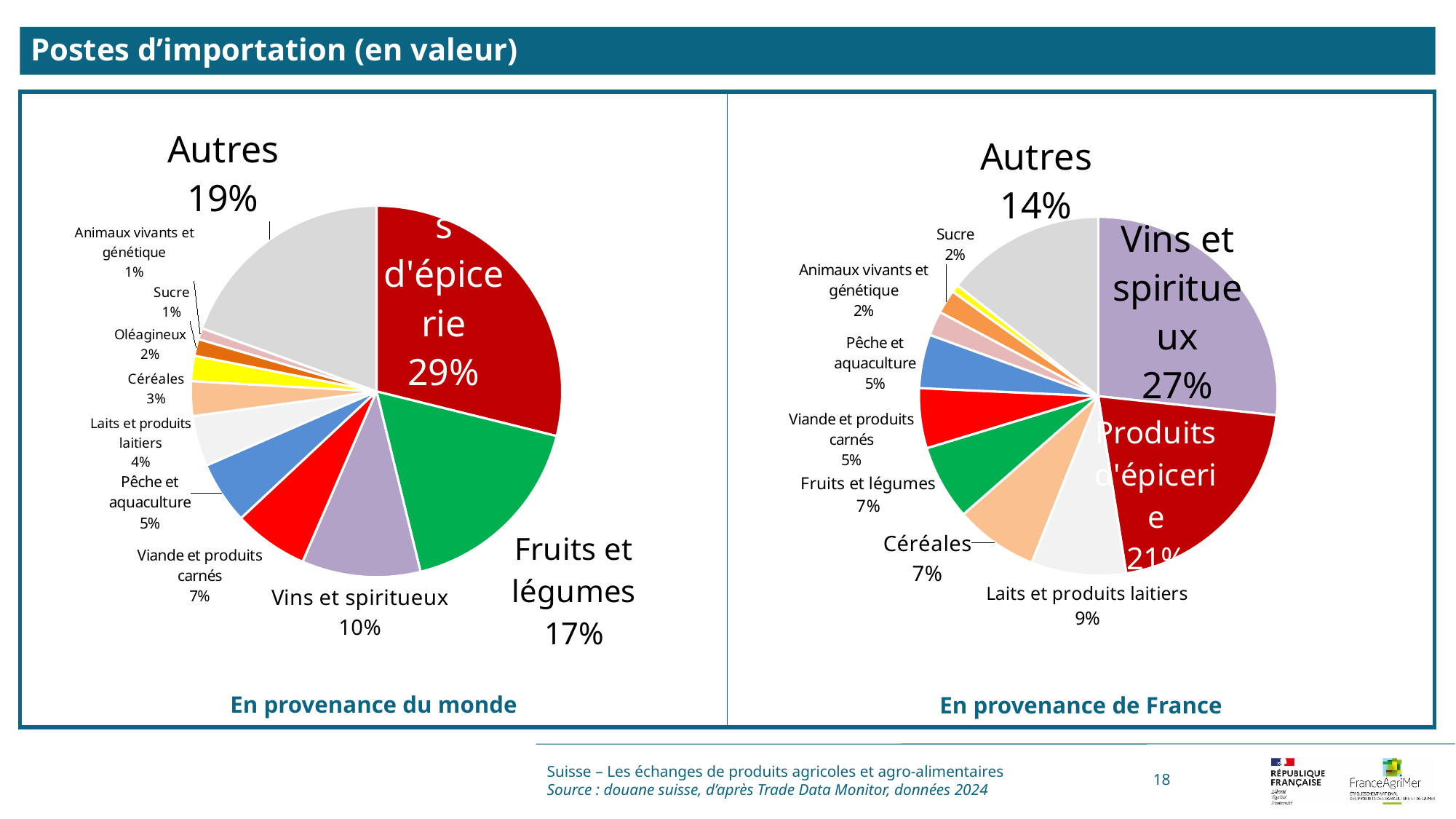
In the 'En provenance de France' pie chart, what share do Vins et spiritueux represent? 27% What type of chart is used on this slide? Pie chart In the 'En provenance du monde' pie chart, what share do Fruits et légumes represent? 17% In the 'En provenance de France' pie chart, what is the difference between the shares of Vins et spiritueux and Produits d'épicerie? 6 percentage points In the 'En provenance de France' pie chart, what share do Laits et produits laitiers represent? 9% In the 'En provenance de France' pie chart, which named category (excluding Autres) has the largest share? Vins et spiritueux Which is larger: the share of Vins et spiritueux in the 'En provenance du monde' chart or in the 'En provenance de France' chart? En provenance de France In the 'En provenance de France' pie chart, what share does the Autres slice represent? 14% In the 'En provenance du monde' pie chart, what is the difference between the shares of Produits d'épicerie and Fruits et légumes? 12 percentage points In the 'En provenance du monde' pie chart, which named category (excluding Autres) has the largest share? Produits d'épicerie In the 'En provenance du monde' pie chart, what share do Produits d'épicerie represent? 29% In the 'En provenance du monde' pie chart, how many slices does the pie have? 11